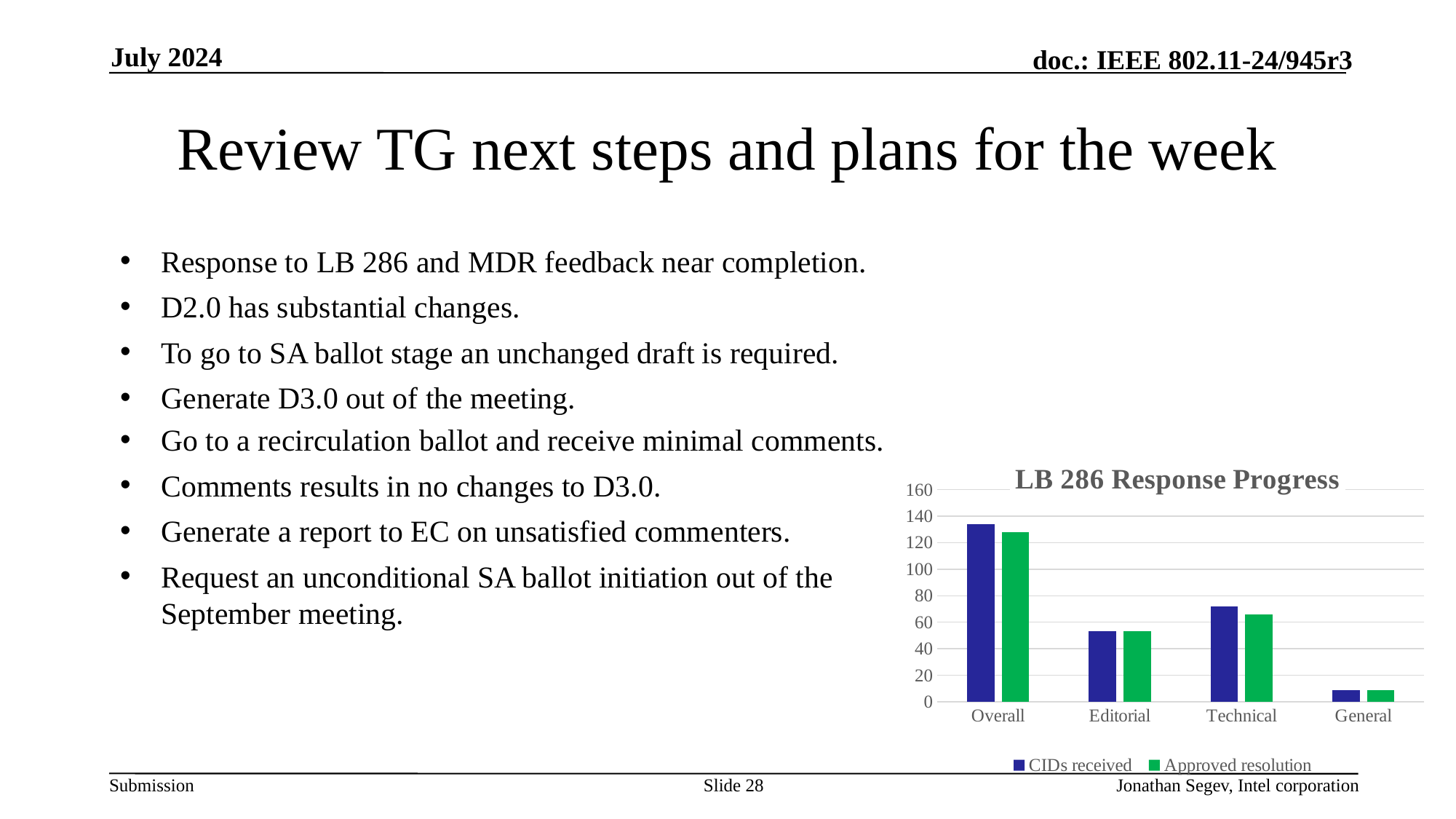
Is the value for CIDs received in the Overall category greater or less than 120? greater Is the value for Approved resolution in the Technical category greater or less than 80? less Which is larger: CIDs received for Overall or CIDs received for Technical? Overall Which category has the highest value for CIDs received? Overall How many series does the chart's legend list? 2 Which category has the lowest value for Approved resolution? General Is the value for Approved resolution in the Editorial category greater or less than 40? greater How many categories are shown on the x axis of the chart? 4 What is the title of the chart? LB 286 Response Progress Which series is shown in green in the chart? Approved resolution What kind of chart is shown on the slide? bar chart